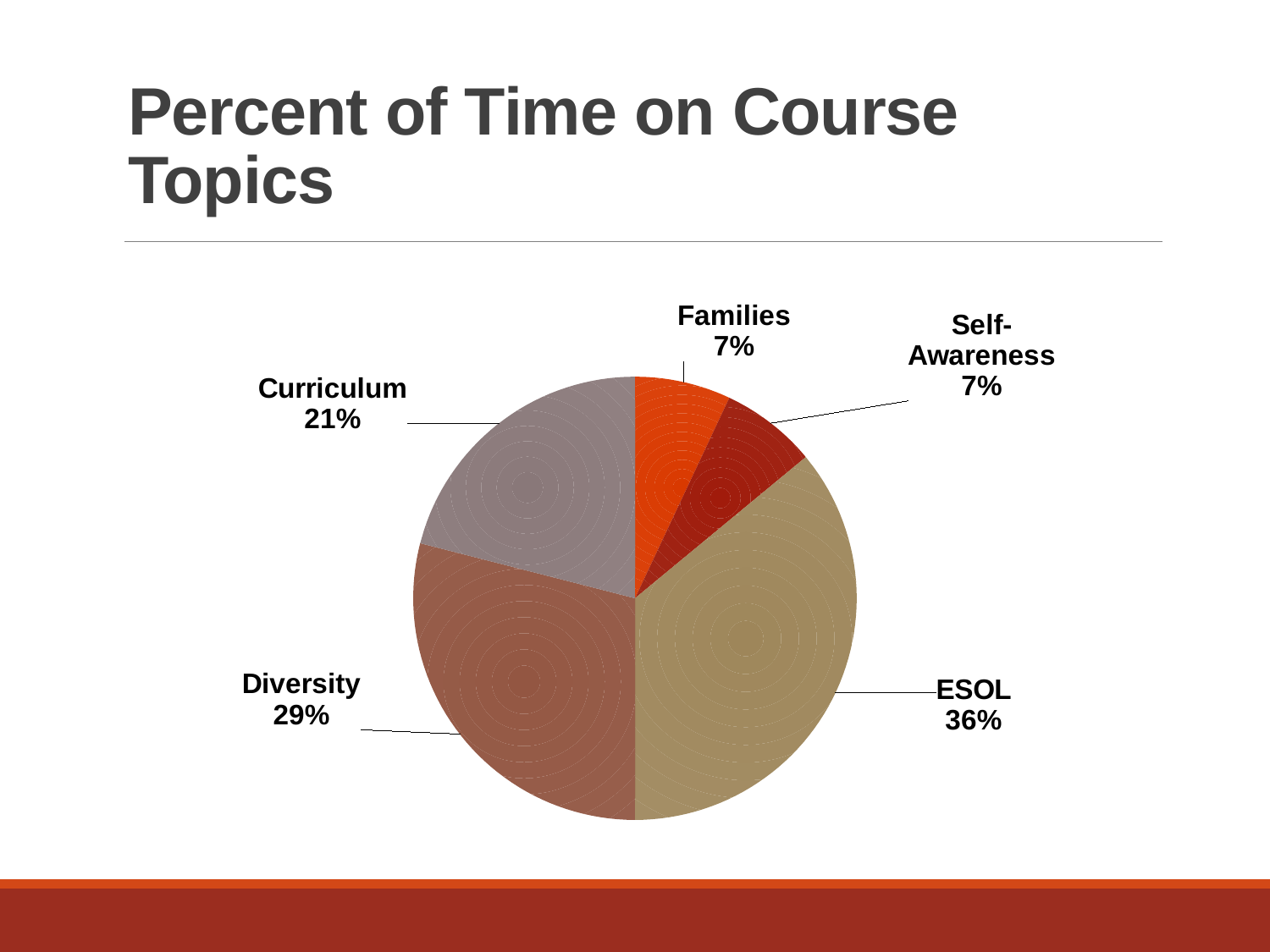
What percent of time is spent on Curriculum? 21% Which course topic takes the largest share of time? ESOL Which takes more time, Curriculum or Diversity? Diversity What is the difference in percentage points between ESOL and Diversity? 7 What is the difference in percentage points between Diversity and Curriculum? 8 How many course topics are shown in the pie chart? 5 What kind of chart is shown on the slide? Pie chart What percent of time is spent on Families? 7% What percent of time is spent on ESOL? 36% What is the title of the slide? Percent of Time on Course Topics What percent of time is spent on Diversity? 29% What is the combined share of Families and Self-Awareness? 14%